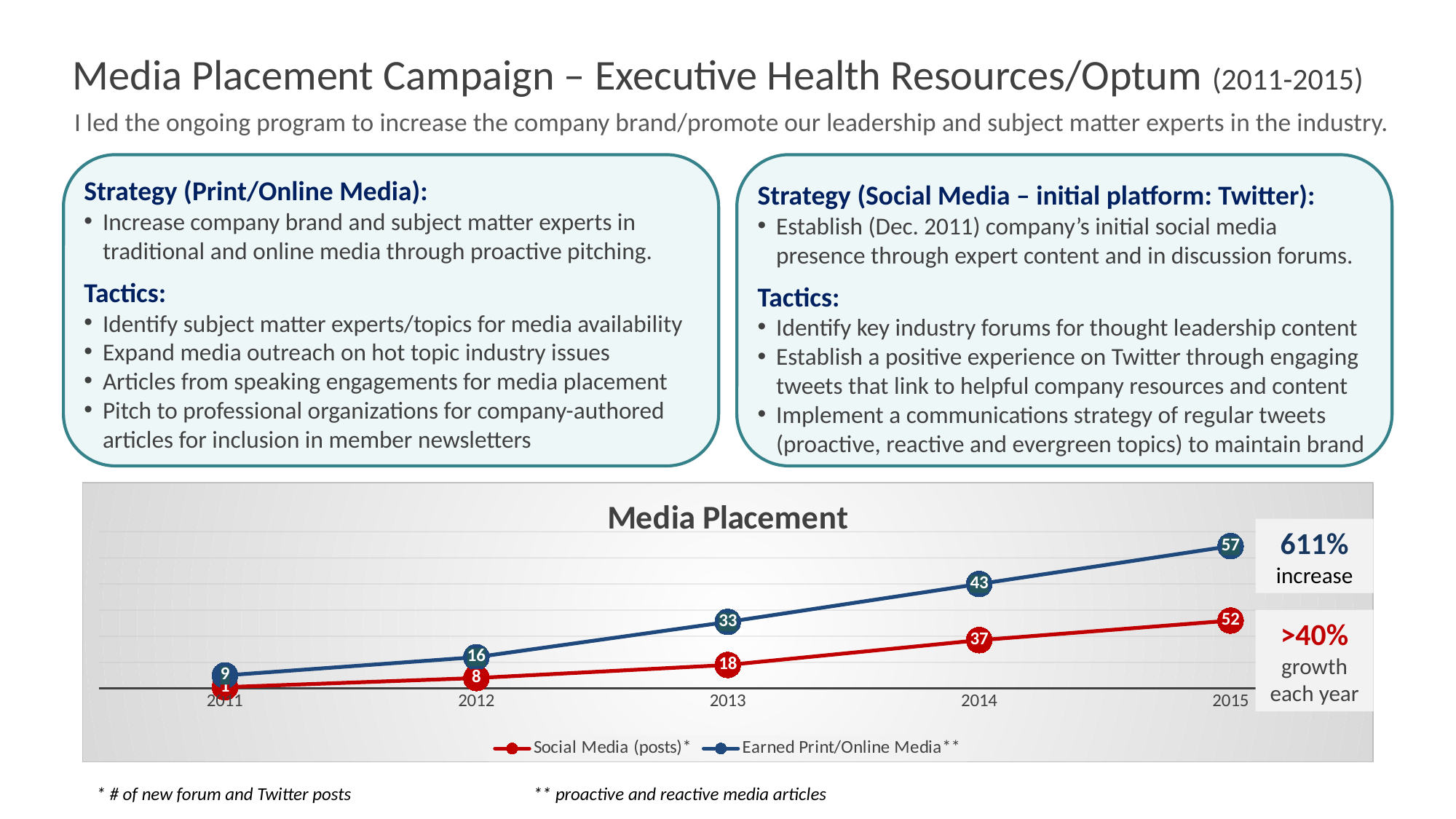
What is the title of the chart? Media Placement What kind of chart is shown on the slide? Line chart What is the difference between Earned Print/Online Media and Social Media (posts) in 2015? 5 Which series has the larger value in 2012, Social Media (posts) or Earned Print/Online Media? Earned Print/Online Media In which year is Social Media (posts) lowest? 2011 What is the value for Social Media (posts) in 2011? 1 How many series does the chart legend list? 2 What is the value for Earned Print/Online Media in 2013? 33 In which year is Earned Print/Online Media highest? 2015 How many years are plotted along the x axis of the chart? 5 Do the values for Social Media (posts) rise or fall from 2011 to 2015? Rise What is the value for Social Media (posts) in 2014? 37